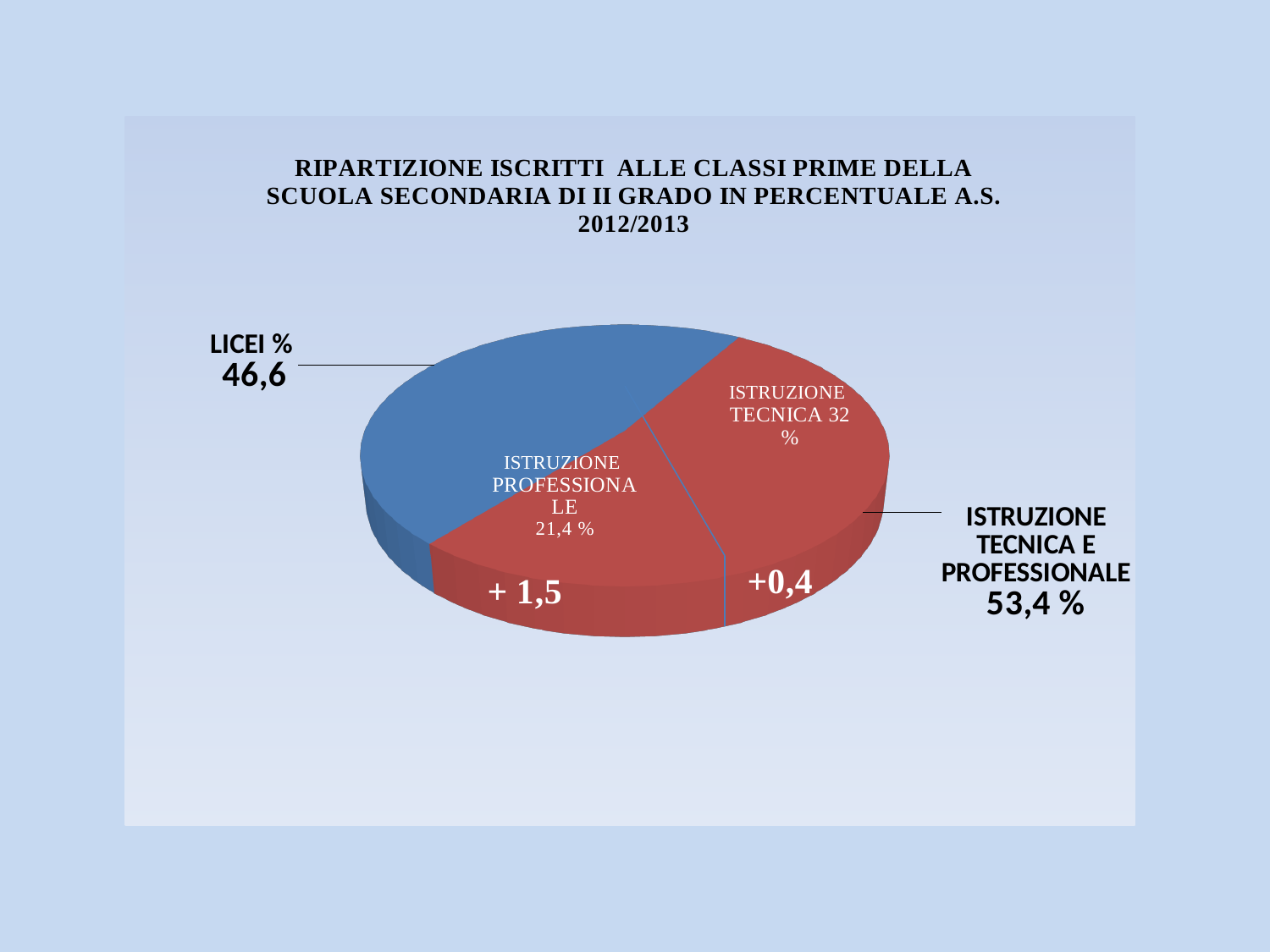
What is the difference between the LICEI share and the ISTRUZIONE TECNICA share? 14,6 What school year does the chart title refer to? 2012/2013 What percentage is shown for ISTRUZIONE PROFESSIONALE? 21,4 % What percentage is shown for ISTRUZIONE TECNICA? 32 % What kind of chart is shown on the slide? Pie chart Which is larger, the share for ISTRUZIONE TECNICA or the share for ISTRUZIONE PROFESSIONALE? ISTRUZIONE TECNICA What colour is the LICEI slice of the pie? Blue What percentage is shown for LICEI? 46,6 What combined percentage is shown for ISTRUZIONE TECNICA E PROFESSIONALE? 53,4 %